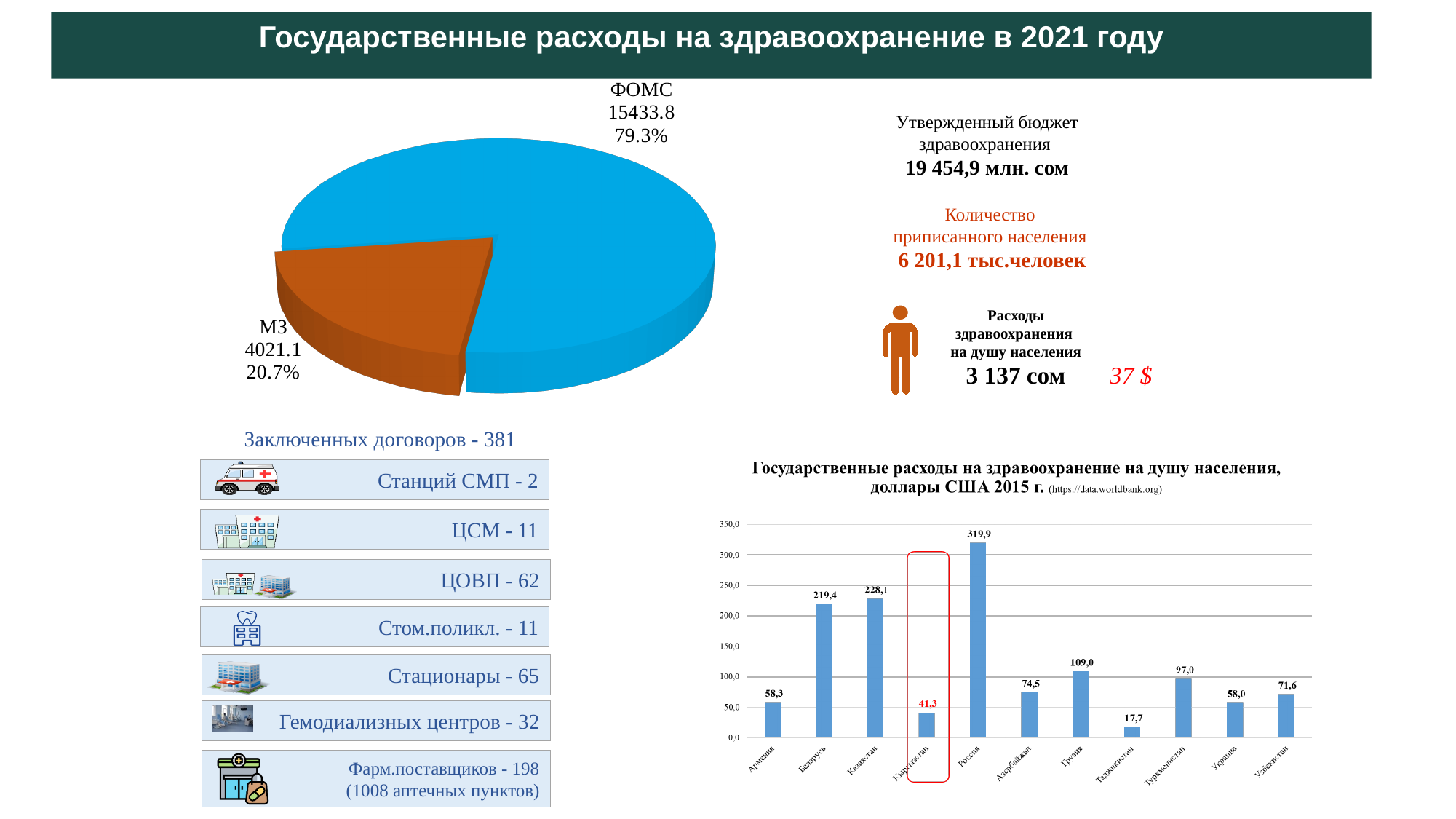
In the bar chart 'Государственные расходы на здравоохранение на душу населения', how many countries are shown? 11 In the bar chart 'Государственные расходы на здравоохранение на душу населения', what is the difference between the values for Казахстан and Беларусь? 8,7 What kind of chart is the one at the bottom right of the slide? Bar chart In the pie chart at the top left, what share of the pie does МЗ have? 20.7% In the pie chart at the top left, which slice is larger, ФОМС or МЗ? ФОМС In the bar chart 'Государственные расходы на здравоохранение на душу населения', what is the value for Узбекистан? 71,6 In the bar chart 'Государственные расходы на здравоохранение на душу населения', which country has the highest value? Россия In the bar chart 'Государственные расходы на здравоохранение на душу населения', which country has the lowest value? Таджикистан In the pie chart at the top left, what value is shown for ФОМС? 15433.8 In the bar chart 'Государственные расходы на здравоохранение на душу населения', what is the value for Кыргызстан? 41,3 How many slices does the pie chart at the top left have? 2 In the bar chart 'Государственные расходы на здравоохранение на душу населения', which is larger, the value for Грузия or the value for Туркменистан? Грузия